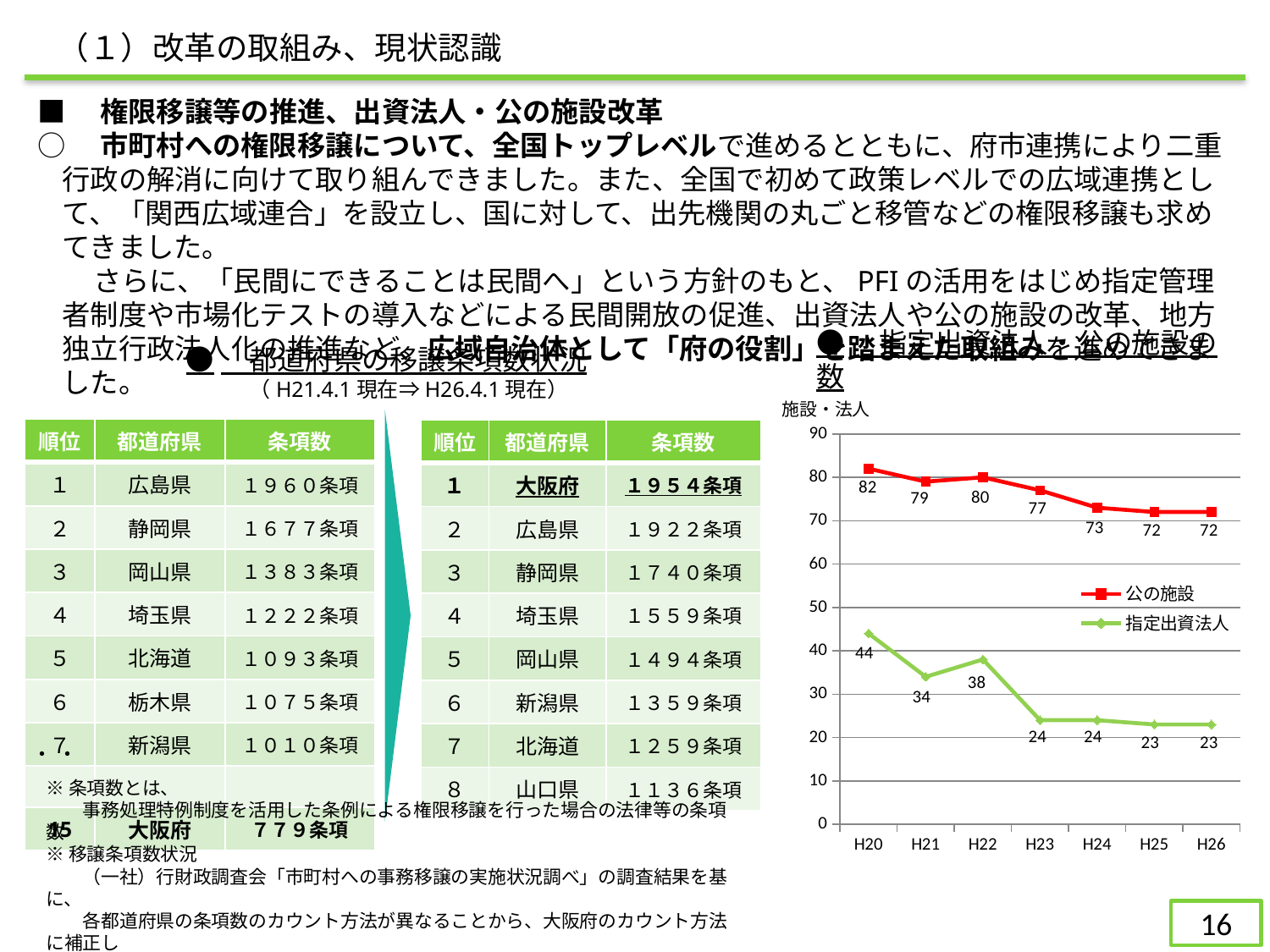
In the line chart, what is the value of 公の施設 for H20? 82 In the line chart, which year has the highest value for 指定出資法人? H20 In the line chart, what is the value of 指定出資法人 for H22? 38 In the line chart, which is larger for H21: 公の施設 or 指定出資法人? 公の施設 In the line chart, what is the difference between the 公の施設 value for H20 and for H26? 10 In the line chart, which year has the lowest value for 公の施設? H25 and H26 What type of chart is shown on the right side of the slide? line chart In the line chart, which series is drawn in red? 公の施設 How many series does the legend of the line chart list? 2 How many points along the x axis does the line chart plot for each series? 7 In the line chart, do the values for 指定出資法人 generally rise or fall from H20 to H26? fall In the line chart, what is the value of 公の施設 for H24? 73